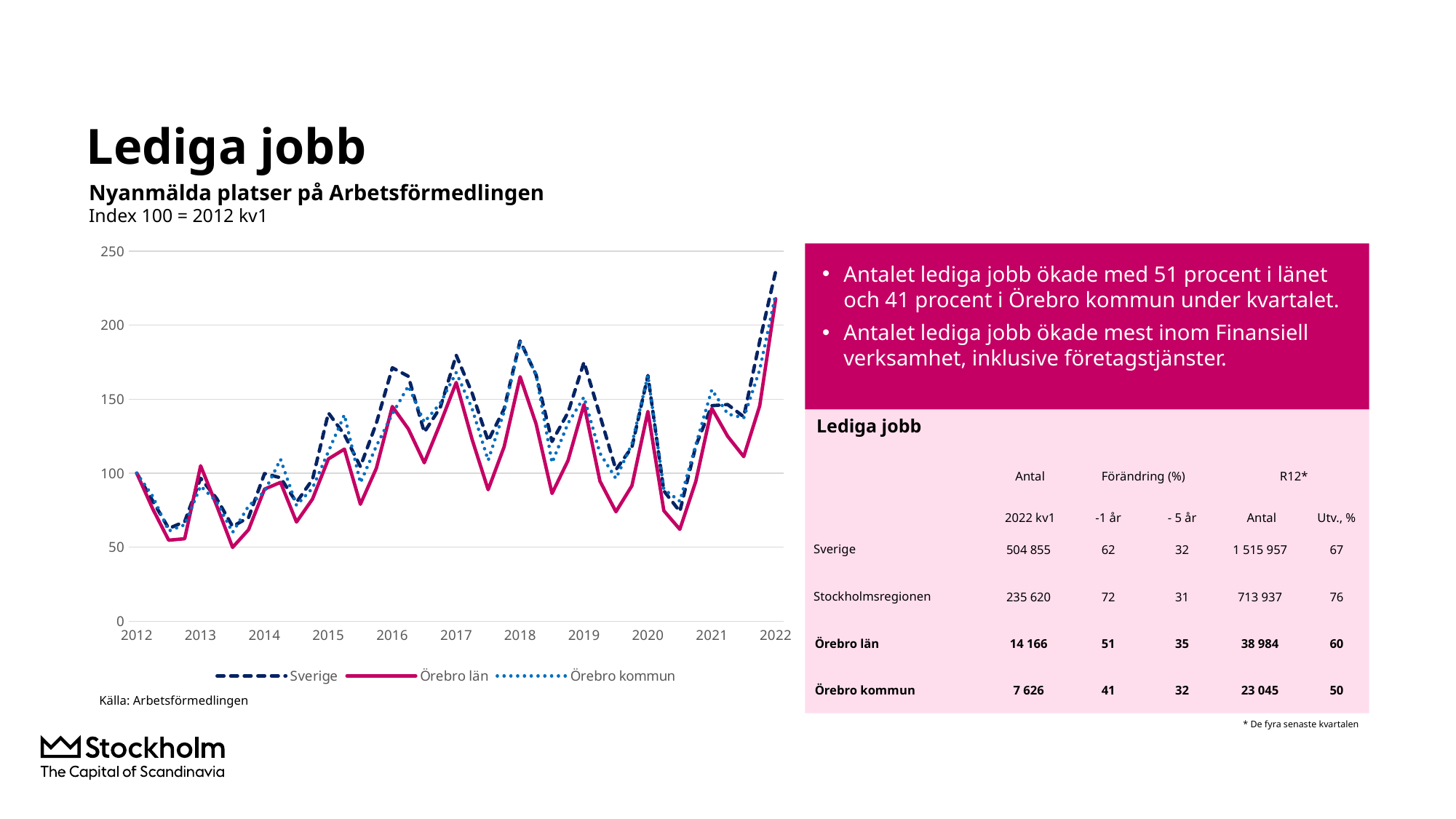
What is the source cited below the chart? Arbetsförmedlingen At the end of the chart in 2022, which series is higher, Sverige or Örebro län? Sverige Overall, do the index values rise or fall from 2012 to 2022? rise How many series does the chart legend list? 3 Is the peak value for Sverige in 2018 greater or less than 150? greater How many year labels are shown on the x axis of the chart? 11 What kind of chart is shown on the slide? line chart Is the value for Örebro län at the end of the chart in 2022 greater or less than 200? greater Which series are listed in the chart legend? Sverige, Örebro län, Örebro kommun What is the index value of all three series at the start of the chart in 2012? 100 Is the value for Sverige at the end of the chart in 2022 greater or less than 200? greater